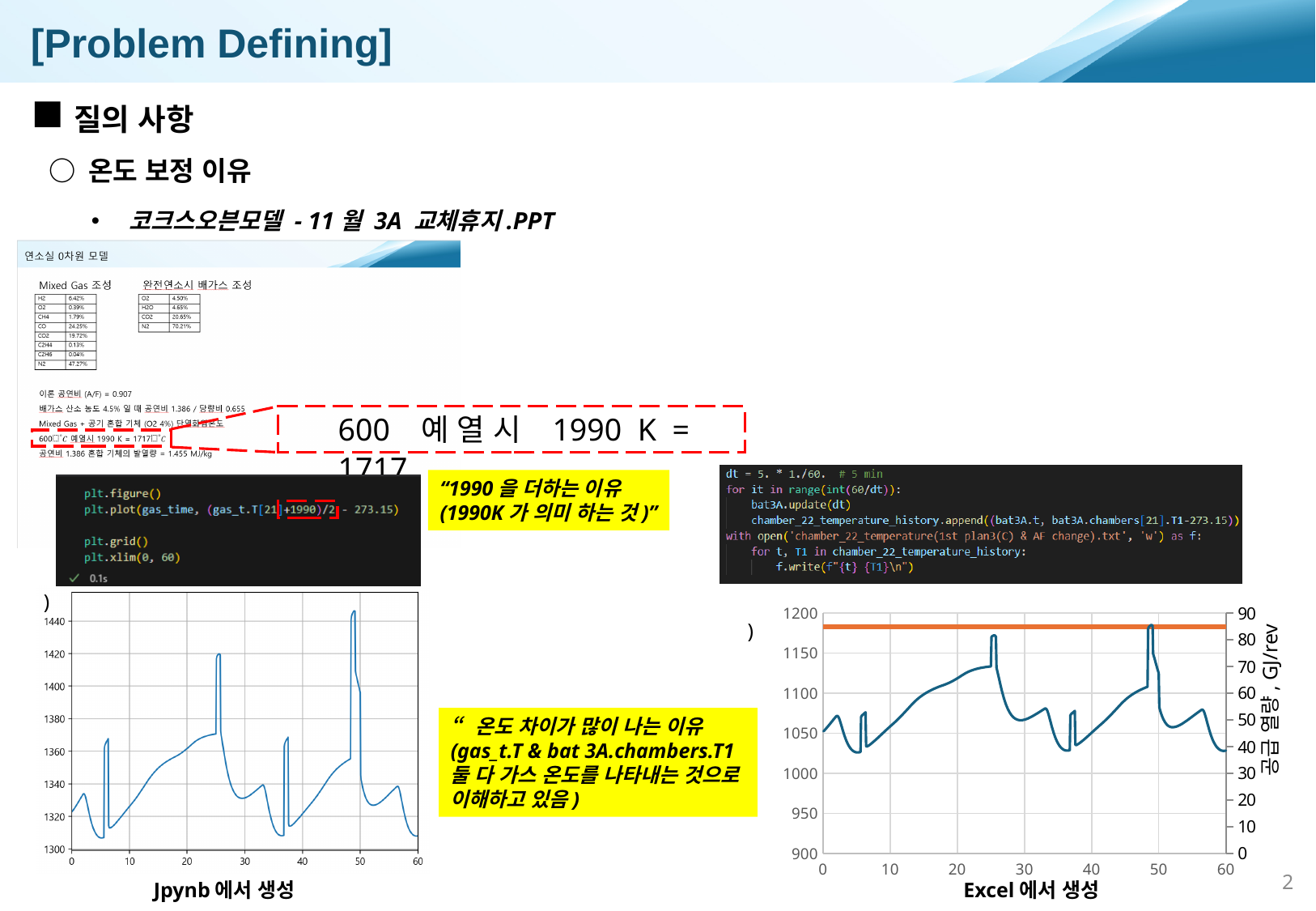
In the right chart ('Excel 에서 생성'), does the orange line rise, fall, or stay flat across the x axis? stays flat How many lines are plotted in the right chart ('Excel 에서 생성')? 2 In the left chart ('Jpynb 에서 생성'), is the highest peak of the line greater or less than 1440? greater In the left chart ('Jpynb 에서 생성'), is the value at x = 60 greater or less than 1320? less What is the label of the secondary (right-hand) y axis of the right chart ('Excel 에서 생성')? 열량, GJ/rev In the right chart ('Excel 에서 생성'), is the value of the blue line at x = 60 greater or less than 1050? less What kind of chart is the chart on the left labelled 'Jpynb 에서 생성'? line chart What kind of chart is the chart on the right labelled 'Excel 에서 생성'? line chart